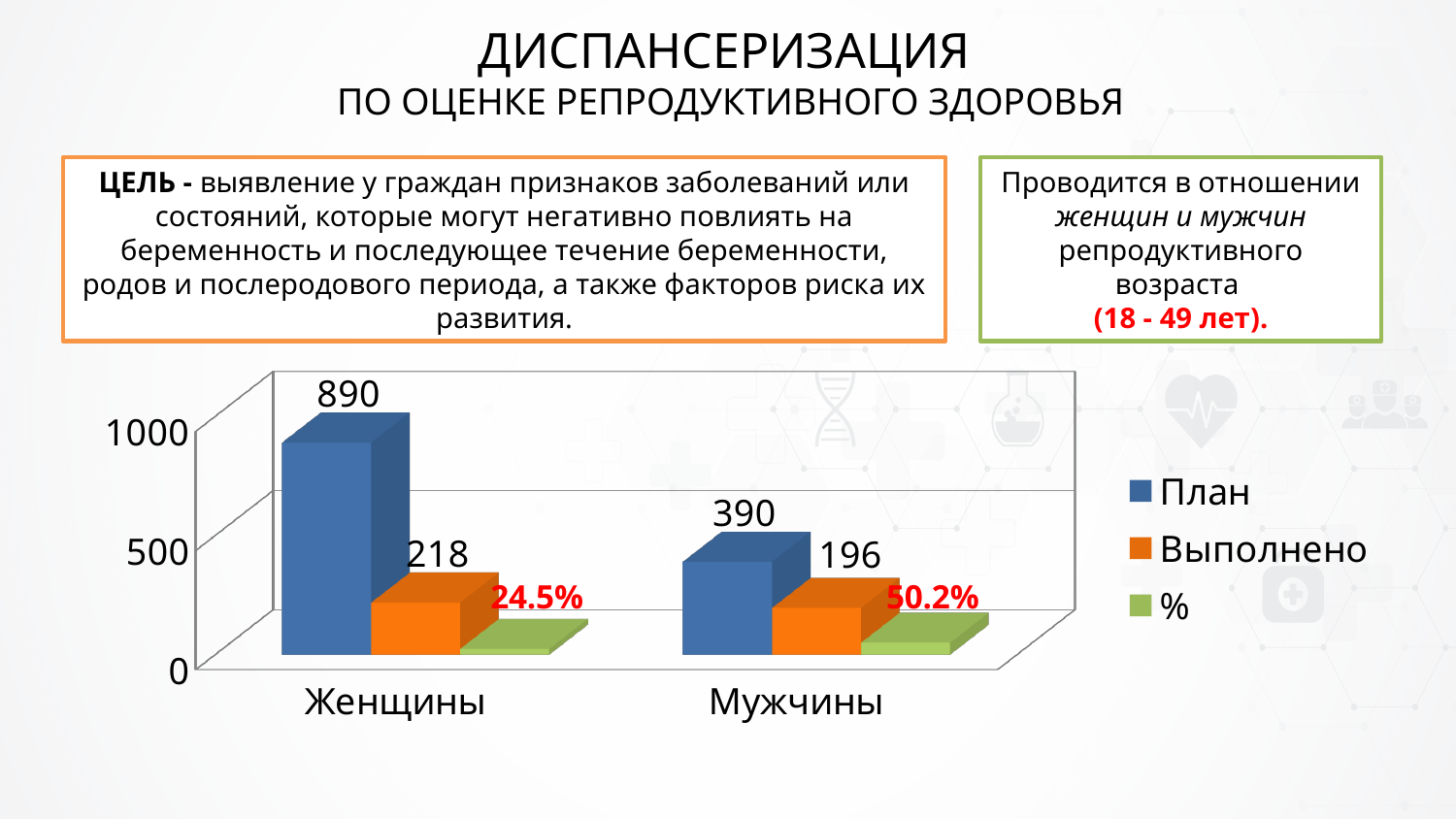
What is the difference between the Выполнено values for Женщины and Мужчины? 22 What is the План value for Женщины? 890 Which category has the higher План value, Женщины or Мужчины? Женщины What is the Выполнено value for Мужчины? 196 Is the План value for Мужчины greater or less than 500? less What is the difference between the План and Выполнено values for Женщины? 672 What is the % value for Женщины? 24.5% How many categories are shown on the x axis? 2 How many series does the legend list? 3 What kind of chart is shown on the slide? bar chart Which colour represents the Выполнено series in the legend? orange What is the План value for Мужчины? 390